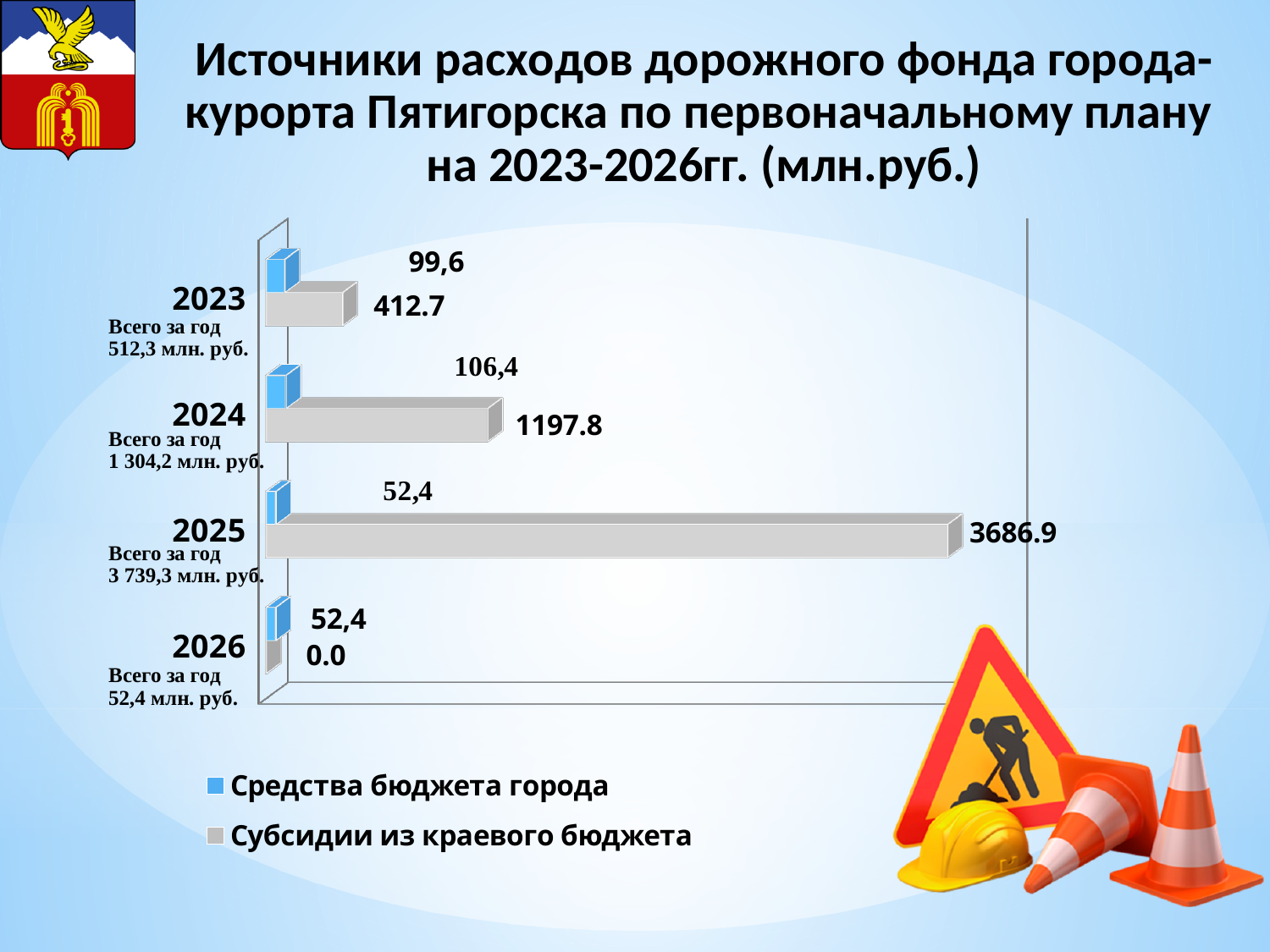
What type of chart is shown on the slide? bar chart What is the difference between 'Субсидии из краевого бюджета' for 2024 and for 2023? 785.1 Which year has the highest value for 'Субсидии из краевого бюджета'? 2025 How many series does the legend list? 2 What is the value of 'Субсидии из краевого бюджета' for 2026? 0.0 Which year has the lowest value for 'Субсидии из краевого бюджета'? 2026 How many years (categories) are shown on the chart? 4 Which is larger: 'Субсидии из краевого бюджета' for 2024 or for 2023? 2024 What is the value of 'Средства бюджета города' for 2023? 99,6 What is the value of 'Субсидии из краевого бюджета' for 2025? 3686.9 What is the value of 'Средства бюджета города' for 2024? 106,4 What colour represents 'Средства бюджета города' in the legend? blue